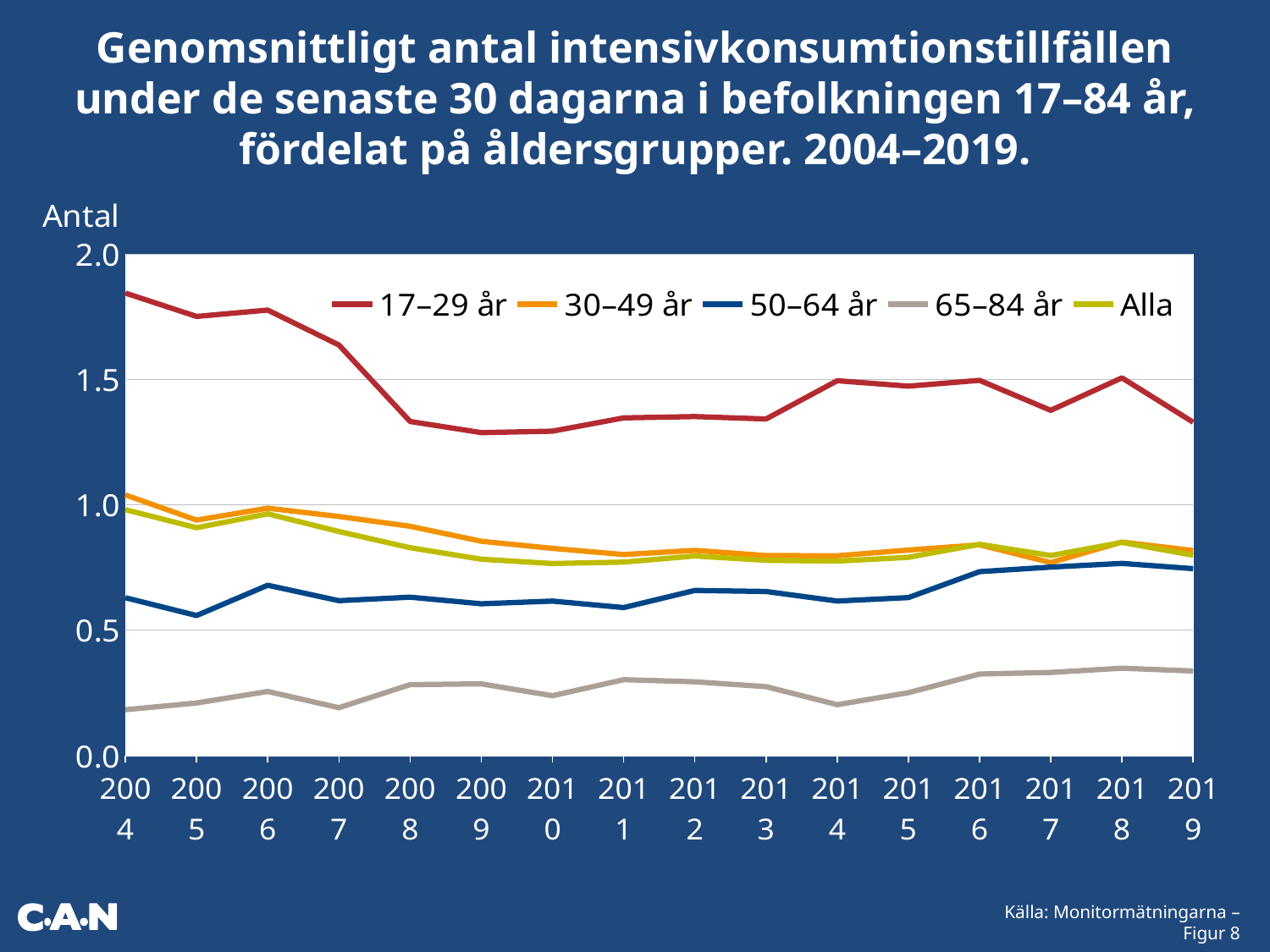
Which age group has the highest value in 2004? 17–29 år Is the value for 17–29 år in 2004 greater or less than 1.5? greater Is the value for 65–84 år in 2004 greater or less than 0.5? less What is the label on the y axis of the chart? Antal Does the value for 17–29 år rise or fall between 2004 and 2008? fall What kind of chart is shown on the slide? Line chart Which age group has the lowest value in 2019? 65–84 år Is the value for 17–29 år in 2009 greater or less than 1.5? less In 2010, which is larger: the value for 50–64 år or the value for 65–84 år? 50–64 år How many years are plotted along the x axis? 16 How many series does the legend list? 5